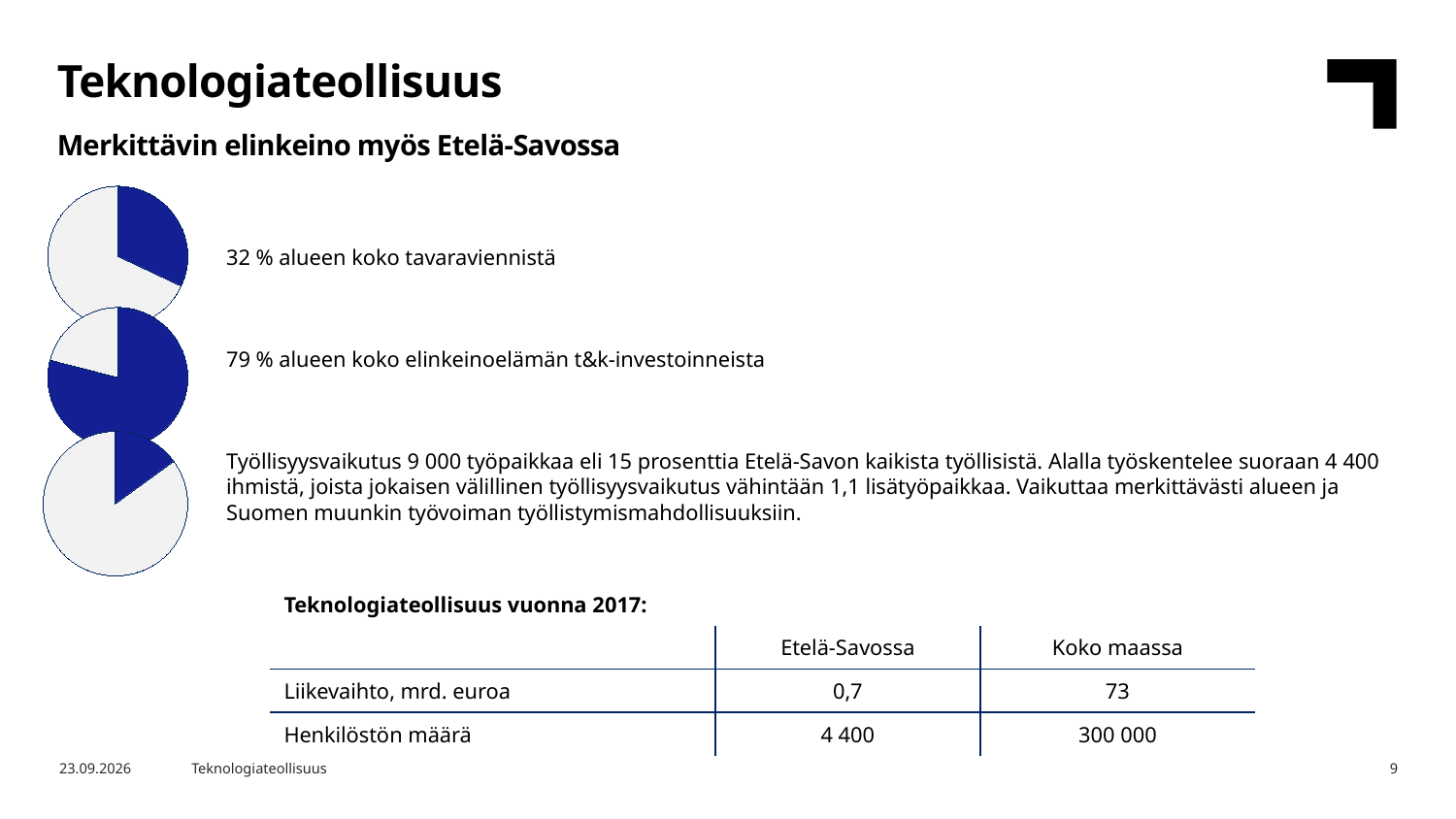
Is the blue slice in the middle pie chart greater or less than half of the pie? greater Is the blue slice in the top pie chart larger or smaller than the blue slice in the bottom pie chart? larger Which of the three pie charts has the largest blue slice? The middle pie chart (79 %) What colour is used for the highlighted slice in each pie chart? Blue Is the blue slice in the top pie chart greater or less than half of the pie? less In the top pie chart, what share of the region's total goods exports does the blue slice represent? 32 % What is the title of the slide containing the pie charts? Teknologiateollisuus How many pie charts are on the slide? 3 What kind of charts are shown on the left side of the slide? Pie charts In the middle pie chart, what share of the region's business R&D investments does the blue slice represent? 79 % Which of the three pie charts has the smallest blue slice? The bottom pie chart (15 prosenttia) In the bottom pie chart, what share of all employed people in Etelä-Savo does the blue slice represent? 15 prosenttia